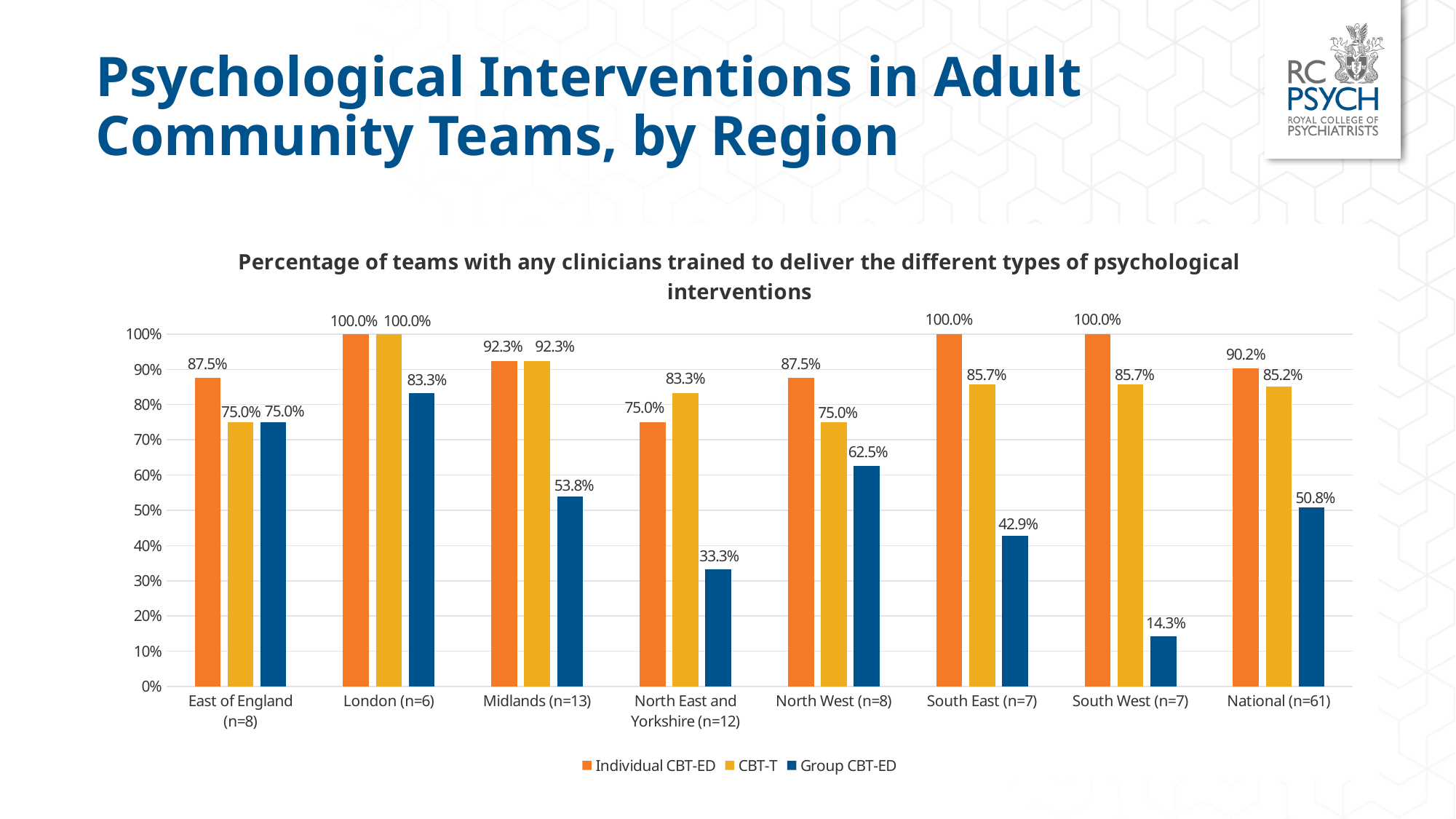
What is the value for CBT-T in North East and Yorkshire (n=12)? 83.3% Which region has the highest value for Group CBT-ED? London (n=6) What is the difference between Individual CBT-ED and Group CBT-ED in South East (n=7)? 57.1% How many regions (categories) are shown on the x axis? 8 Which region has the lowest value for Group CBT-ED? South West (n=7) How many series does the legend list? 3 What kind of chart is shown on the slide? Bar chart What is the value for Group CBT-ED in South West (n=7)? 14.3% Which colour represents Group CBT-ED in the legend? Dark blue Is the value for Group CBT-ED in Midlands (n=13) greater or less than 50%? greater Which is larger in North West (n=8): CBT-T or Group CBT-ED? CBT-T What is the value for Individual CBT-ED in National (n=61)? 90.2%